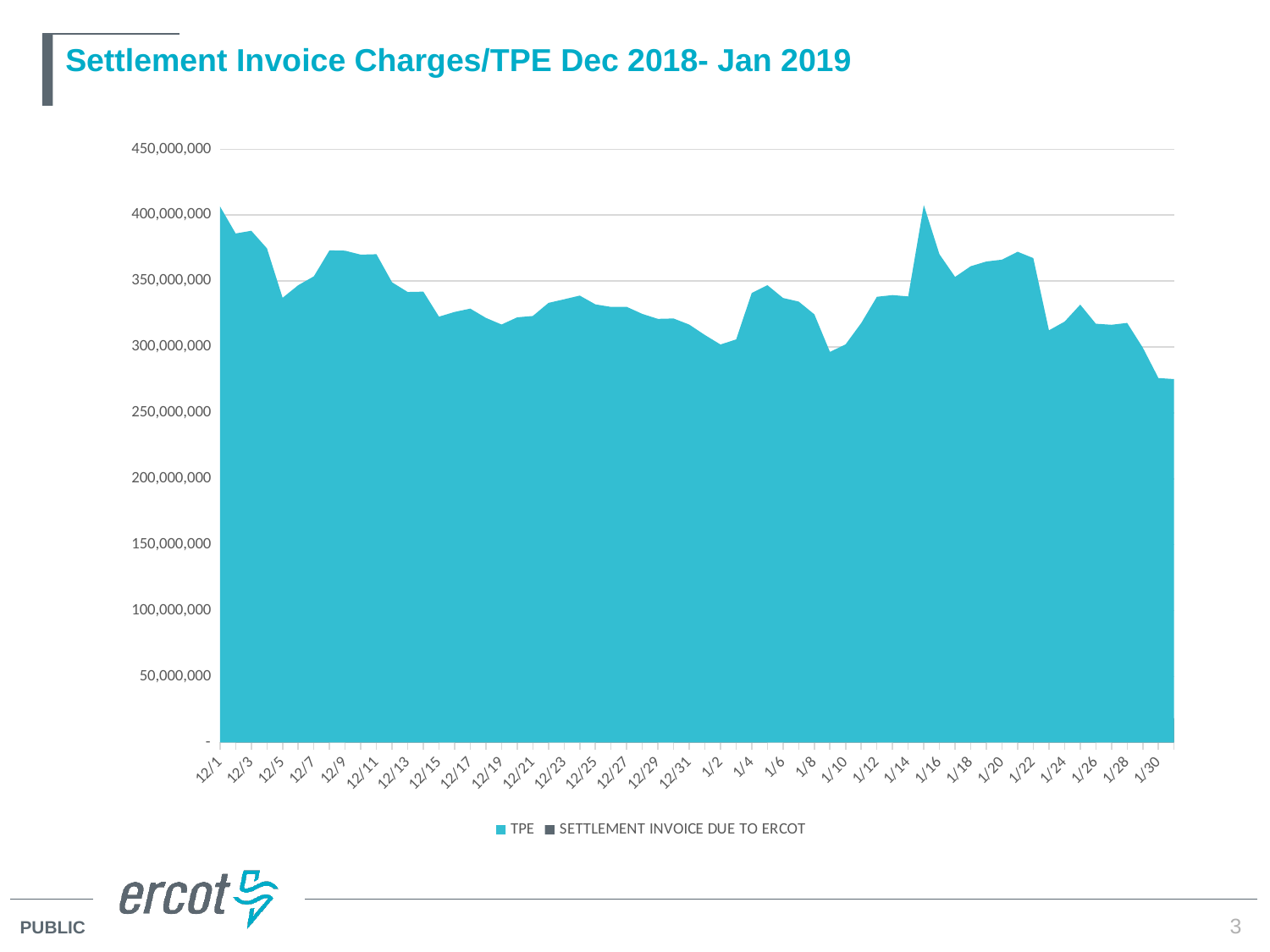
Is the TPE value for 12/1 greater or less than 350,000,000? greater Overall, does the TPE value rise or fall from 12/1 to 1/30? Fall How many series does the legend list? 2 What are the two series named in the legend? TPE and SETTLEMENT INVOICE DUE TO ERCOT Which has the larger TPE value, 12/1 or 1/30? 12/1 Is the TPE value for 1/15 greater or less than 350,000,000? greater Is the TPE value for 1/30 greater or less than 300,000,000? less What is the title of the chart? Settlement Invoice Charges/TPE Dec 2018- Jan 2019 Which has the larger TPE value, 1/9 or 1/15? 1/15 What kind of chart is shown on the slide? Area chart